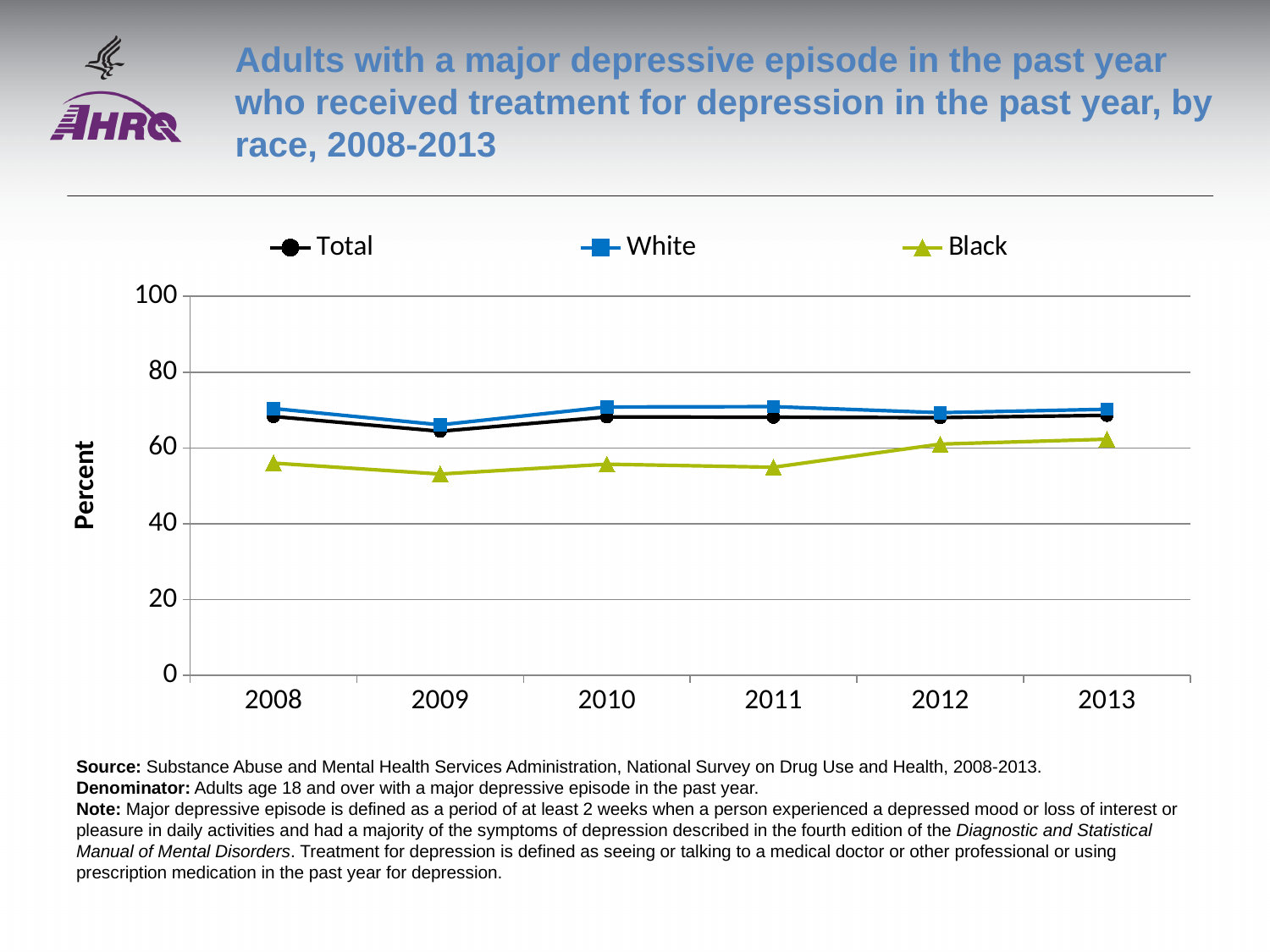
In which year is the value for Black lowest? 2009 Which series are listed in the legend? Total, White, Black What kind of chart is shown on the slide? Line chart In 2008, which is larger, the value for White or the value for Black? White How many series does the legend list? 3 Is the value for Total in 2009 greater or less than 60? greater In which year is the value for White lowest? 2009 Is the value for White in 2010 greater or less than 80? less How many years are plotted along the x axis? 6 Is the value for White in 2008 greater or less than 60? greater What is the label of the y axis? Percent